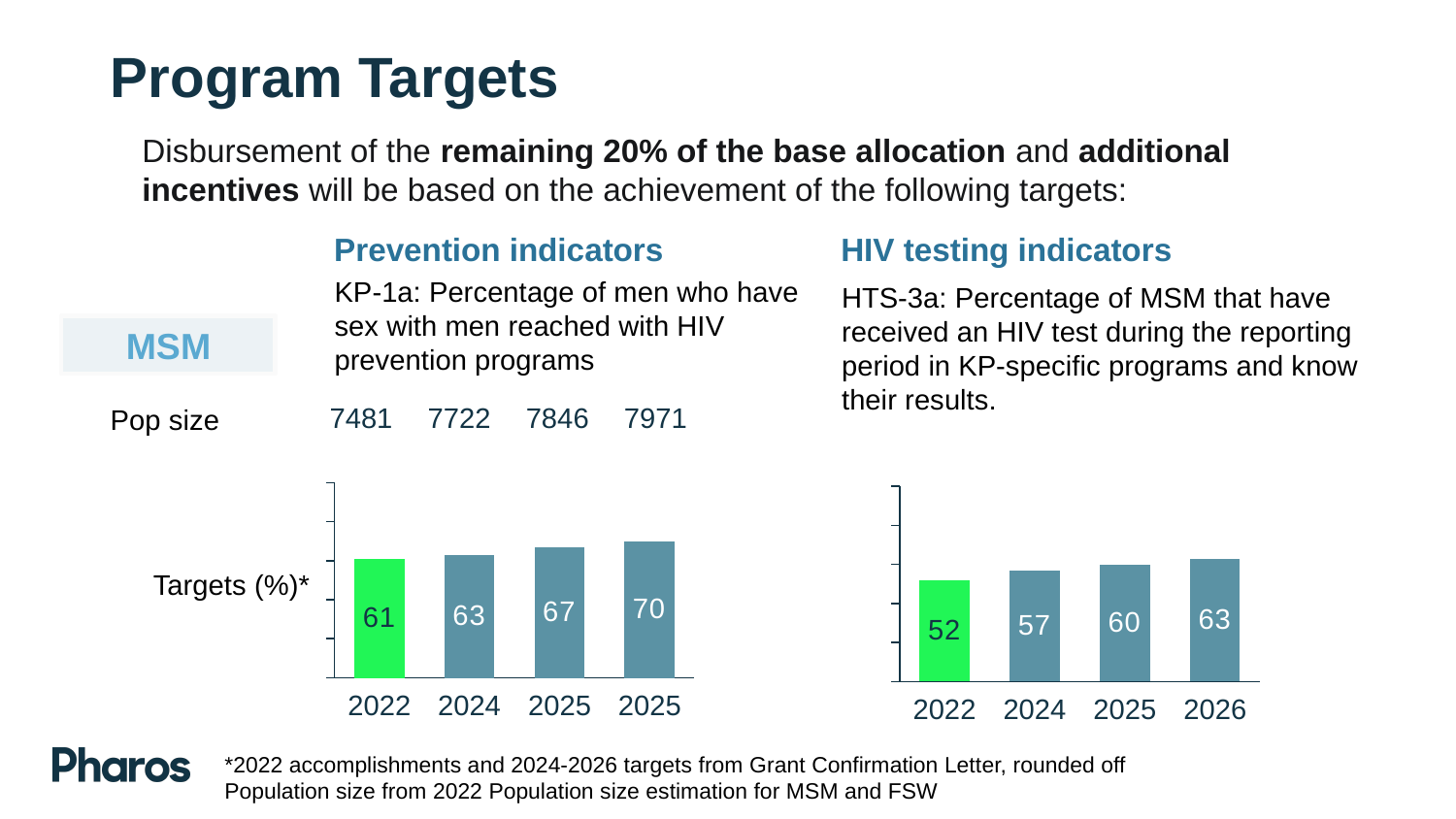
Which is larger: the 2024 value in the Prevention indicators chart or the 2024 value in the HIV testing indicators chart? Prevention indicators (63) In the HIV testing indicators chart on the right, what is the value for 2024? 57 In the HIV testing indicators chart on the right, what is the value for 2026? 63 In the Prevention indicators chart on the left, what is the target value for 2022? 61 What type of chart is used for the Prevention indicators targets on the left? Bar chart In the Prevention indicators chart on the left, which bar has the highest value? The rightmost bar (70) In the HIV testing indicators chart on the right, do the values rise or fall from 2022 to 2026? Rise In the Prevention indicators chart on the left, what is the difference between the 2024 value and the 2022 value? 2 How many bars are in the HIV testing indicators chart on the right? 4 In the HIV testing indicators chart on the right, what is the difference between the 2026 value and the 2022 value? 11 In the Prevention indicators chart on the left, what is the value of the last (rightmost) bar? 70 In the HIV testing indicators chart on the right, which year has the lowest value? 2022